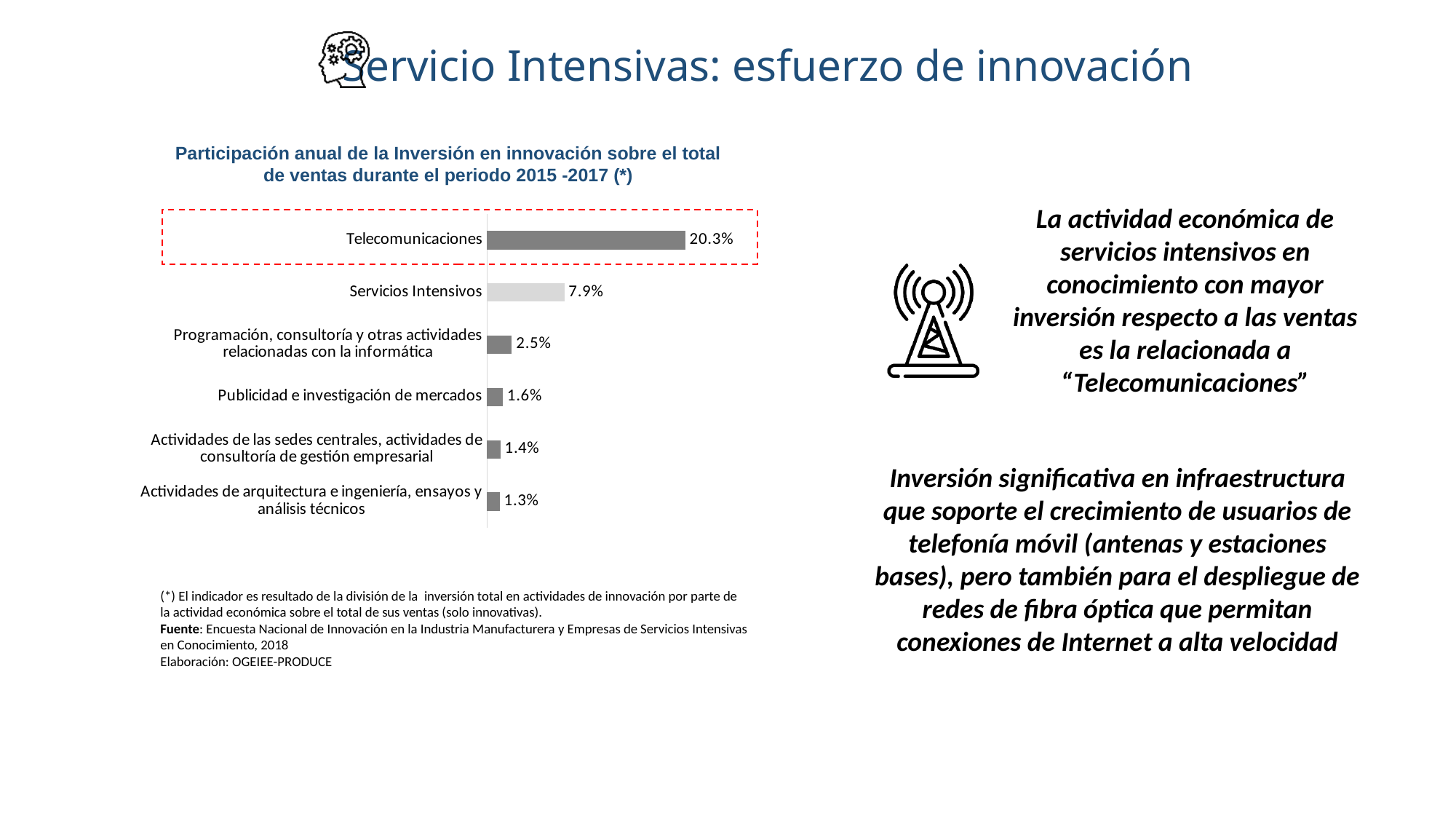
Which category's bar is highlighted with a red dashed box? Telecomunicaciones What is the value for Servicios Intensivos? 7.9% What kind of chart is shown on the slide? Bar chart What is the difference between the values for Telecomunicaciones and Servicios Intensivos? 12.4% What is the value for Telecomunicaciones? 20.3% What is the value for Actividades de arquitectura e ingeniería, ensayos y análisis técnicos? 1.3% Which is larger, the value for Programación, consultoría y otras actividades relacionadas con la informática or the value for Publicidad e investigación de mercados? Programación, consultoría y otras actividades relacionadas con la informática What is the title of the chart? Participación anual de la Inversión en innovación sobre el total de ventas durante el periodo 2015 -2017 (*) How many categories are shown in the chart? 6 Which category has the highest value? Telecomunicaciones Which category has the lowest value? Actividades de arquitectura e ingeniería, ensayos y análisis técnicos What is the value for Publicidad e investigación de mercados? 1.6%